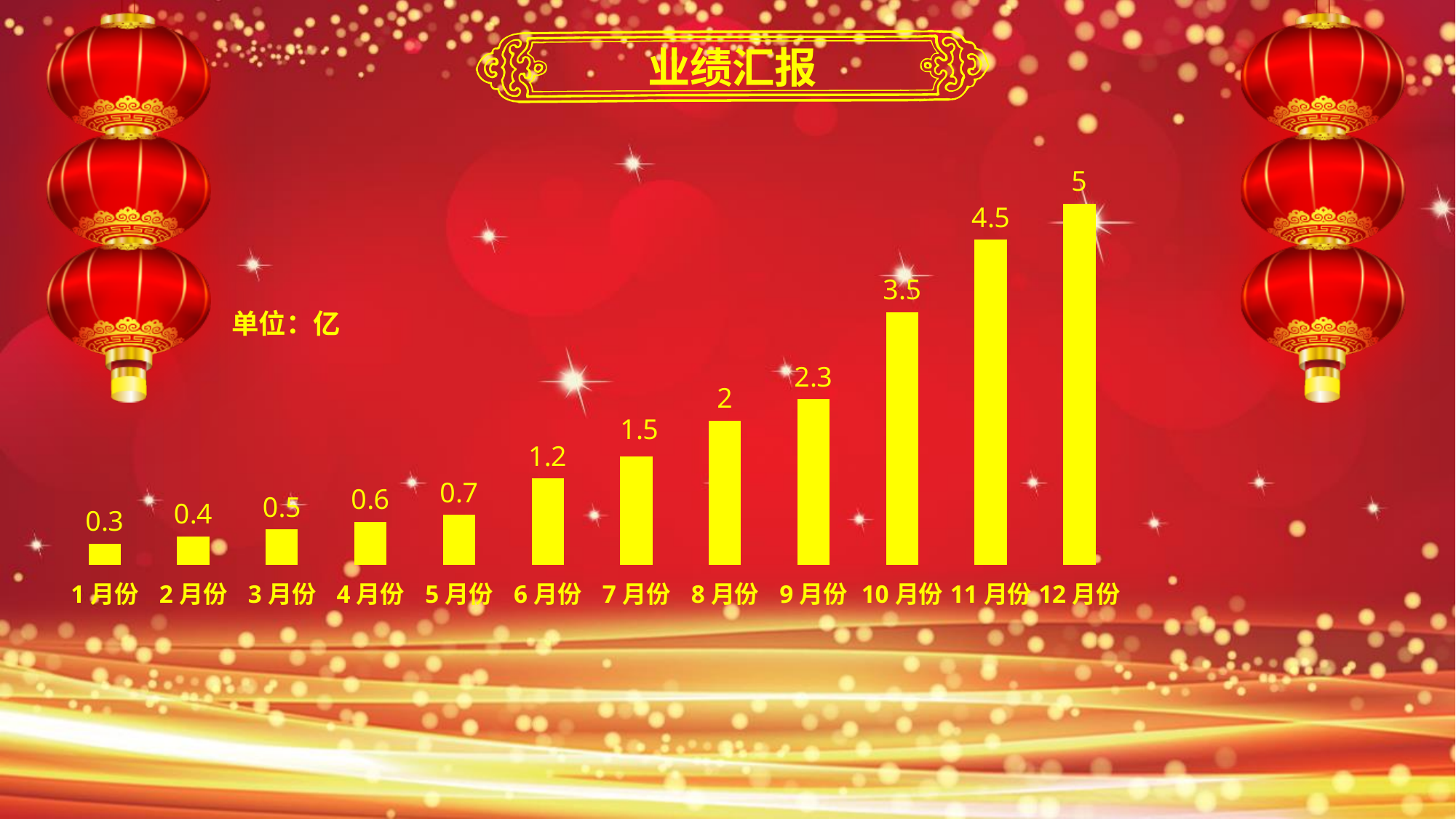
Do the values rise or fall from 1月份 to 12月份? rise How many months are shown in the chart? 12 Which month has the lowest value? 1月份 What is the value for 6月份? 1.2 What is the value for 1月份? 0.3 What is the value for 10月份? 3.5 What unit is stated for the chart values? 亿 Which month has the highest value? 12月份 What is the difference between the values for 9月份 and 8月份? 0.3 What kind of chart is shown on the slide? bar chart Which is larger, the value for 7月份 or the value for 5月份? 7月份 What is the difference between the values for 12月份 and 11月份? 0.5